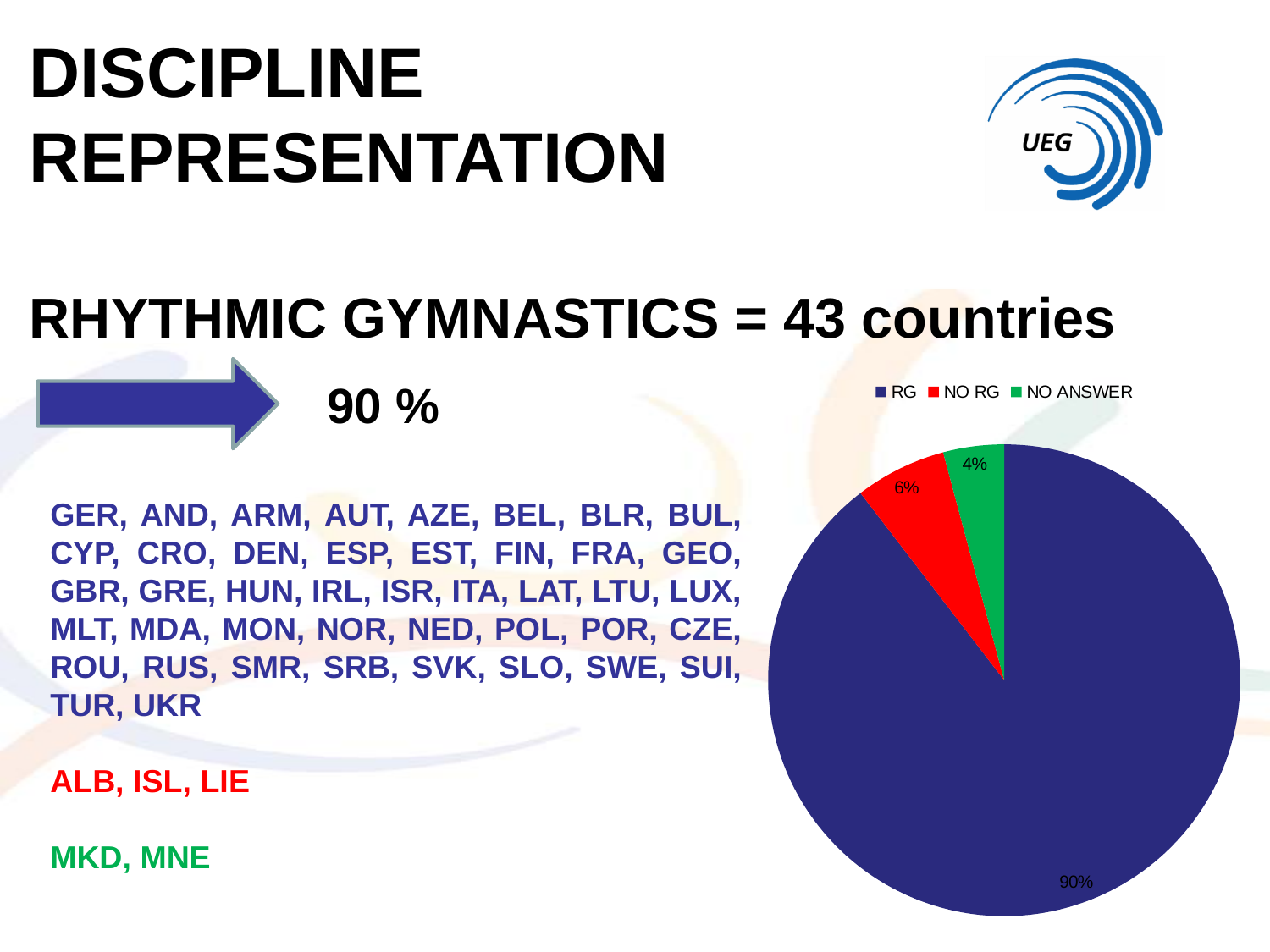
Which slice of the pie chart is the smallest? NO ANSWER Which slice of the pie chart is the largest? RG What is the difference in percentage points between the NO RG slice and the NO ANSWER slice? 2 Which is larger, the NO RG slice or the NO ANSWER slice? NO RG What share of the pie does RG represent? 90% What share of the pie does NO RG represent? 6% What colour is the RG slice in the pie chart? dark blue What is the difference in percentage points between the RG slice and the NO RG slice? 84 What share of the pie does NO ANSWER represent? 4% How many slices does the pie chart have? 3 What kind of chart is shown on the slide? pie chart How many entries does the legend list? 3